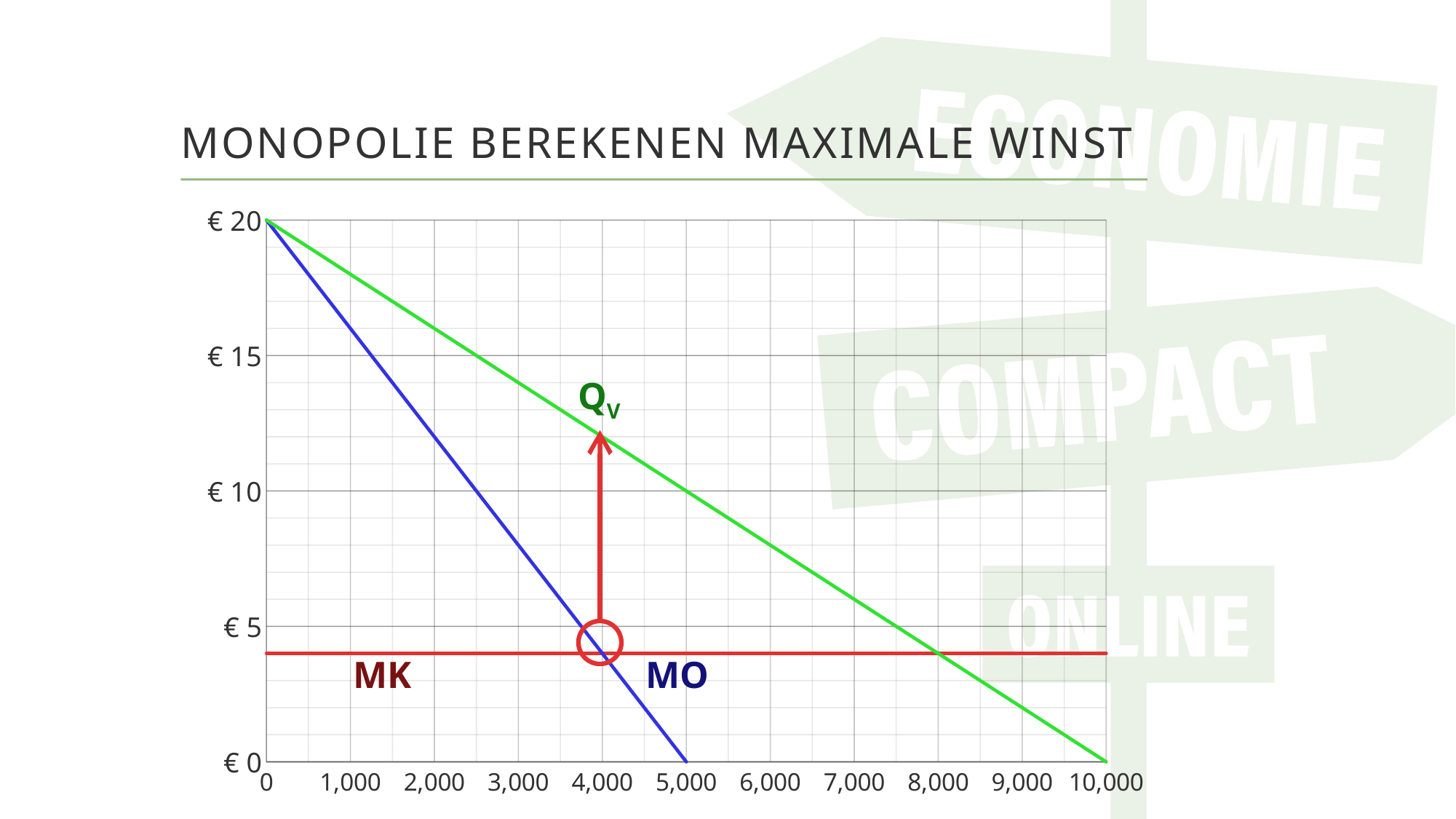
At what quantity does the blue MO line reach € 0? 5,000 How many lines are plotted on the chart? 3 Does the blue MO line rise or fall as quantity increases? fall What is the title of the chart on the slide? MONOPOLIE BEREKENEN MAXIMALE WINST What is the value of the green line at quantity 0? € 20 Is the value of the green line at quantity 4,000 greater or less than € 10? greater What colour is the line labelled MK? red At quantity 4,000, which line is higher: the green line or the blue MO line? the green line Is the value of the blue MO line at quantity 2,000 greater or less than € 15? less Is the value of the red MK line greater or less than € 5? less At what quantity does the green line reach € 0? 10,000 What kind of chart is shown on the slide? line chart